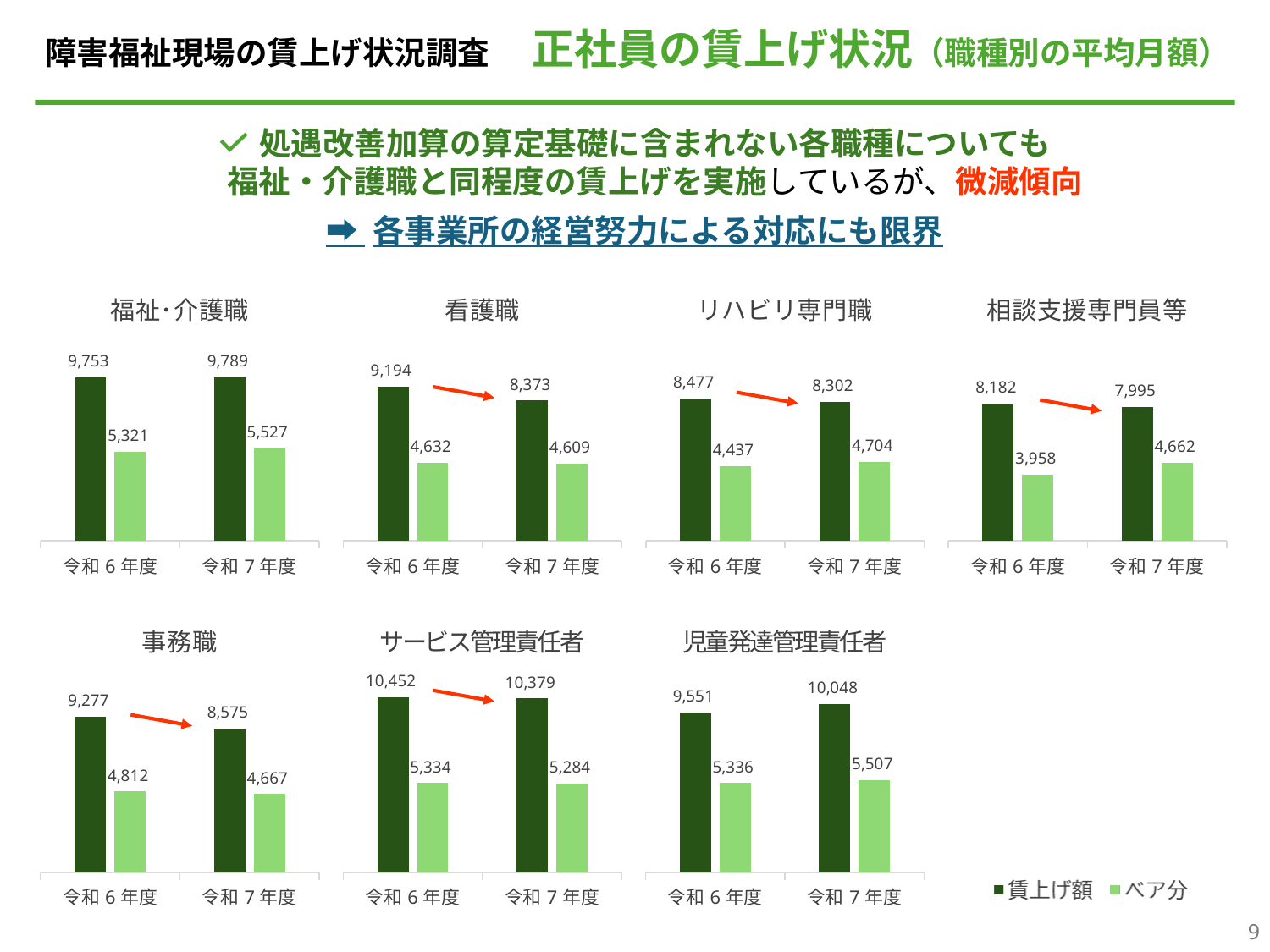
In the リハビリ専門職 chart, what is the difference in ベア分 between 令和７年度 and 令和６年度? 267 In the 相談支援専門員等 chart, what is the 賃上げ額 value for 令和６年度? 8,182 What kind of chart is used for 看護職? bar chart In the サービス管理責任者 chart, which year has the higher 賃上げ額, 令和６年度 or 令和７年度? 令和６年度 In the 児童発達管理責任者 chart, does the 賃上げ額 rise or fall from 令和６年度 to 令和７年度? rise How many series does the legend list? 2 In the 相談支援専門員等 chart, which year has the lowest ベア分 value? 令和６年度 In the 福祉・介護職 chart, what is the 賃上げ額 value for 令和７年度? 9,789 In the 事務職 chart, what is the difference in 賃上げ額 between 令和６年度 and 令和７年度? 702 Across all seven charts, which chart shows the highest 賃上げ額 value, and what is it? サービス管理責任者, 10,452 How many categories (years) are shown on the x axis of the 事務職 chart? 2 In the 看護職 chart, what is the ベア分 value for 令和６年度? 4,632